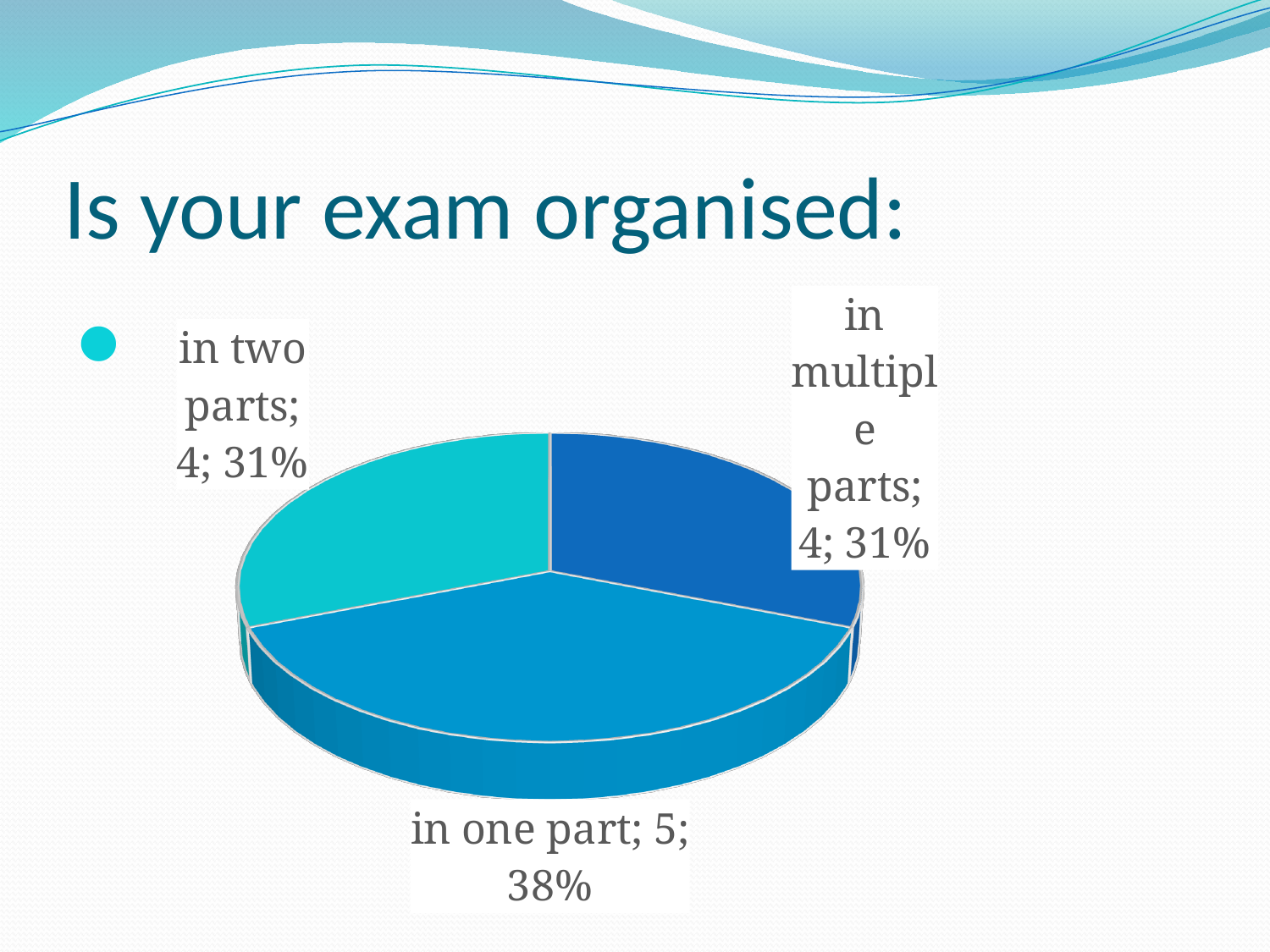
What is the count for 'in two parts'? 4 What is the difference in count between 'in one part' and 'in two parts'? 1 What is the count for 'in one part'? 5 What percentage of the pie is 'in two parts'? 31% What percentage of the pie is 'in one part'? 38% What kind of chart is shown on the slide? pie chart How many slices does the pie chart have? 3 What percentage of the pie is 'in multiple parts'? 31% Which is larger, the slice for 'in one part' or the slice for 'in multiple parts'? in one part What is the count for 'in multiple parts'? 4 Which category has the largest slice? in one part What is the total count across all slices of the pie? 13